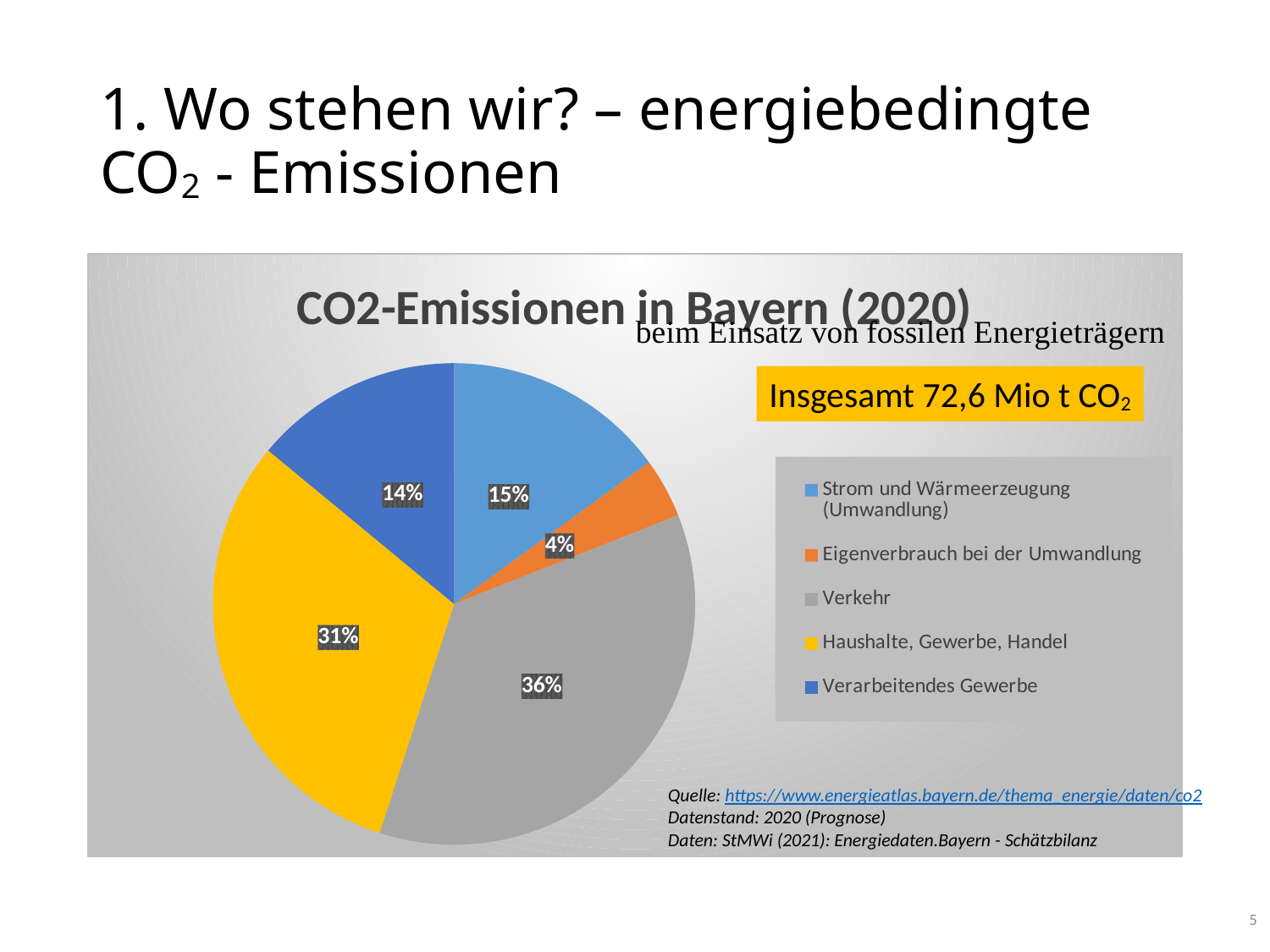
Which category has the largest slice of the pie? Verkehr What share of the pie does Strom und Wärmeerzeugung (Umwandlung) account for? 15% What is the title of the chart? CO2-Emissionen in Bayern (2020) What is the difference in percentage points between Verkehr and Haushalte, Gewerbe, Handel? 5% What share of the pie does Haushalte, Gewerbe, Handel account for? 31% Which is larger, the share for Verkehr or the share for Haushalte, Gewerbe, Handel? Verkehr Which category has the smallest slice of the pie? Eigenverbrauch bei der Umwandlung What kind of chart is shown on the slide? pie chart What share of the pie does Verkehr account for? 36% How many categories does the legend list? 5